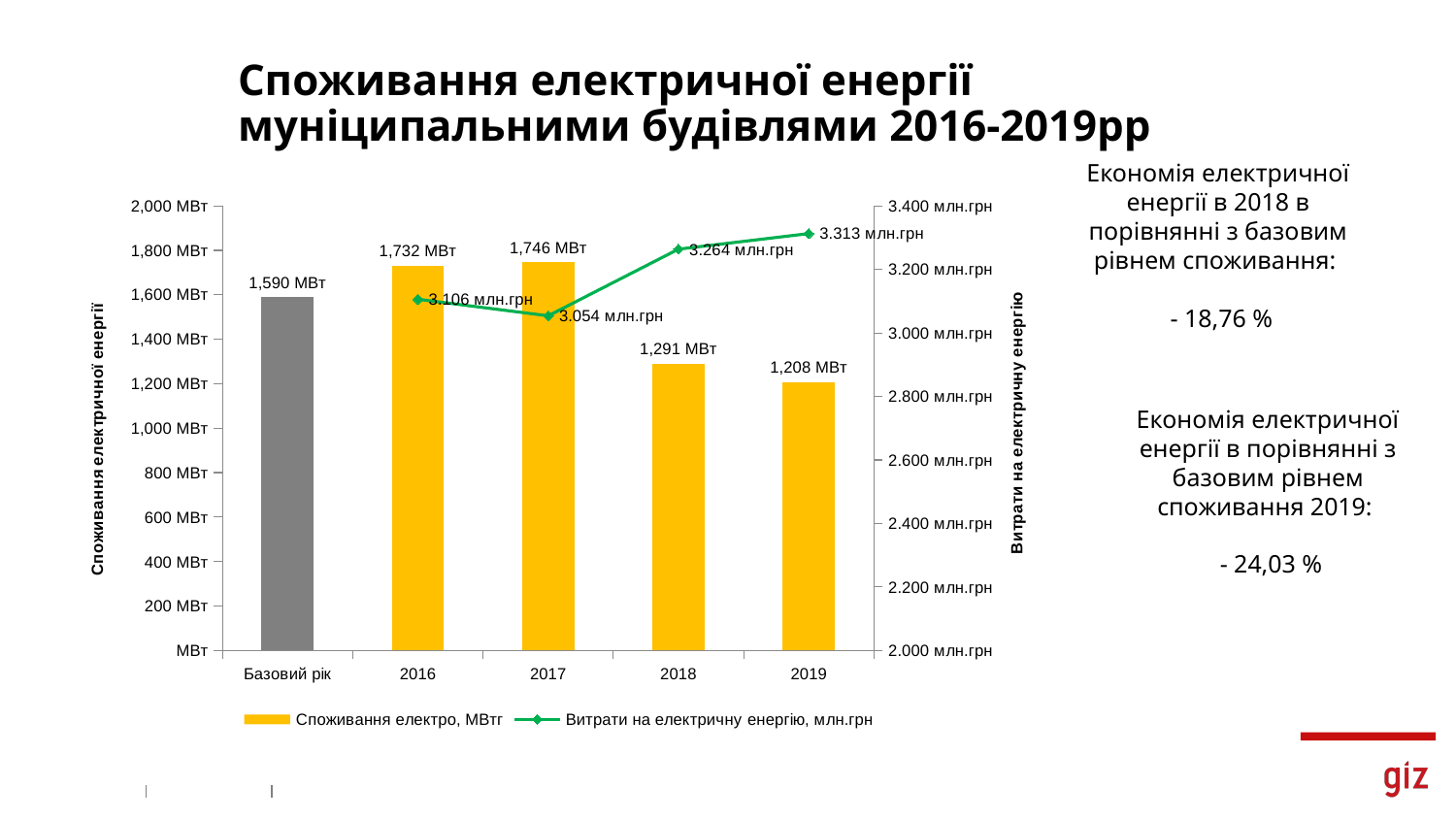
Which category has the lowest electricity consumption (Споживання електро)? 2019 How many series does the legend list? 2 What kind of chart is used to show Споживання електро, МВтг? Bar chart What is the electricity consumption value shown for Базовий рік? 1,590 МВт Which year has the higher electricity cost (Витрати на електричну енергію): 2016 or 2018? 2018 What is the difference in electricity consumption between 2016 and 2019? 524 МВт What is the value of Витрати на електричну енергію for 2017? 3.054 млн.грн What is the value of Витрати на електричну енергію for 2019? 3.313 млн.грн What is the electricity consumption value shown for 2018? 1,291 МВт Does the electricity cost (Витрати на електричну енергію) rise or fall from 2017 to 2019? Rise How many categories are shown on the x axis? 5 Which category has the highest electricity consumption (Споживання електро)? 2017